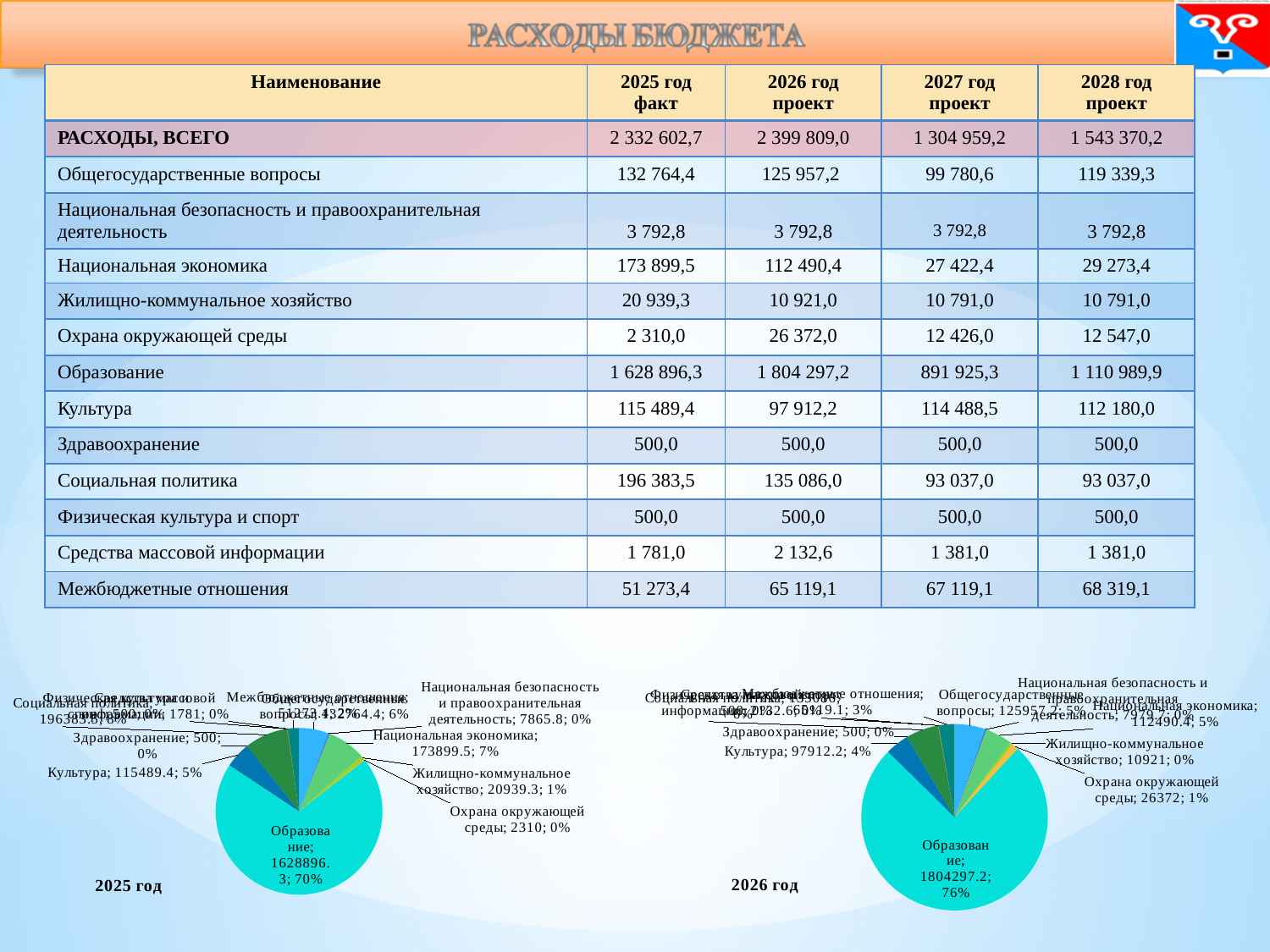
In the "2026 год" pie chart, what share does Образование have? 76% In the "2026 год" pie chart, what value is shown for Охрана окружающей среды? 26372 In the "2025 год" pie chart, what share does Образование have? 70% In the "2025 год" pie chart, which is larger: Культура or Национальная экономика? Национальная экономика What kind of chart is the "2025 год" chart? pie chart How many pie charts are shown on the slide? 2 In the "2026 год" pie chart, what share does Культура have? 4% In the "2025 год" pie chart, which category has the largest slice? Образование In the "2025 год" pie chart, what value is shown for Культура? 115489.4 In the "2026 год" pie chart, which category has the largest slice? Образование In the "2026 год" pie chart, what value is shown for Жилищно-коммунальное хозяйство? 10921